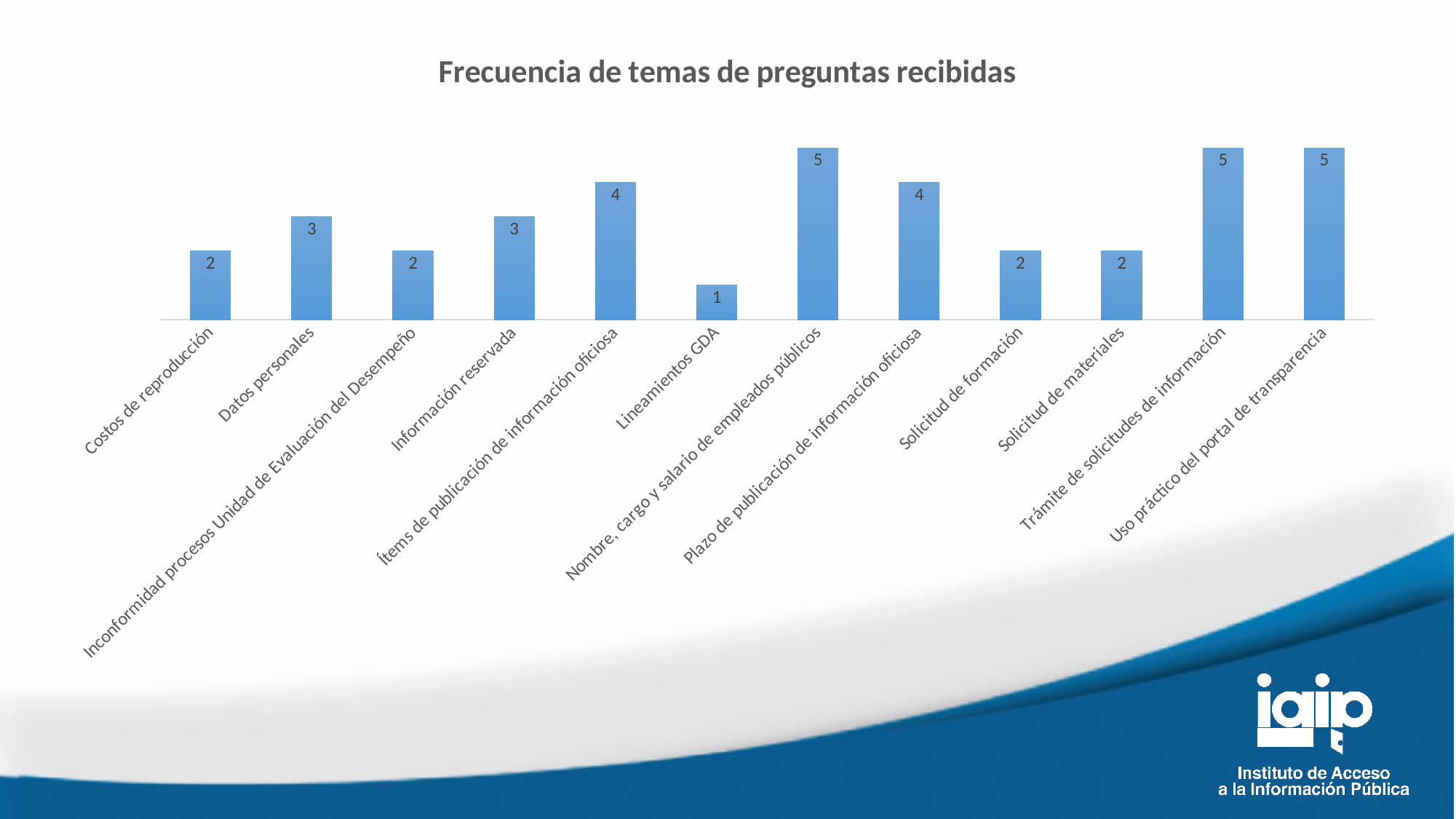
What is the value for Ítems de publicación de información oficiosa? 4 What kind of chart is shown on the slide? bar chart What is the value for Lineamientos GDA? 1 What is the title of the chart? Frecuencia de temas de preguntas recibidas Which category has the lowest value? Lineamientos GDA What is the value for Uso práctico del portal de transparencia? 5 How many categories have a value of 5? 3 What is the value for Datos personales? 3 Which is larger, the value for Datos personales or the value for Solicitud de materiales? Datos personales How many categories are plotted in the chart? 12 What is the difference between the values for Nombre, cargo y salario de empleados públicos and Lineamientos GDA? 4 What is the difference between the values for Trámite de solicitudes de información and Solicitud de formación? 3